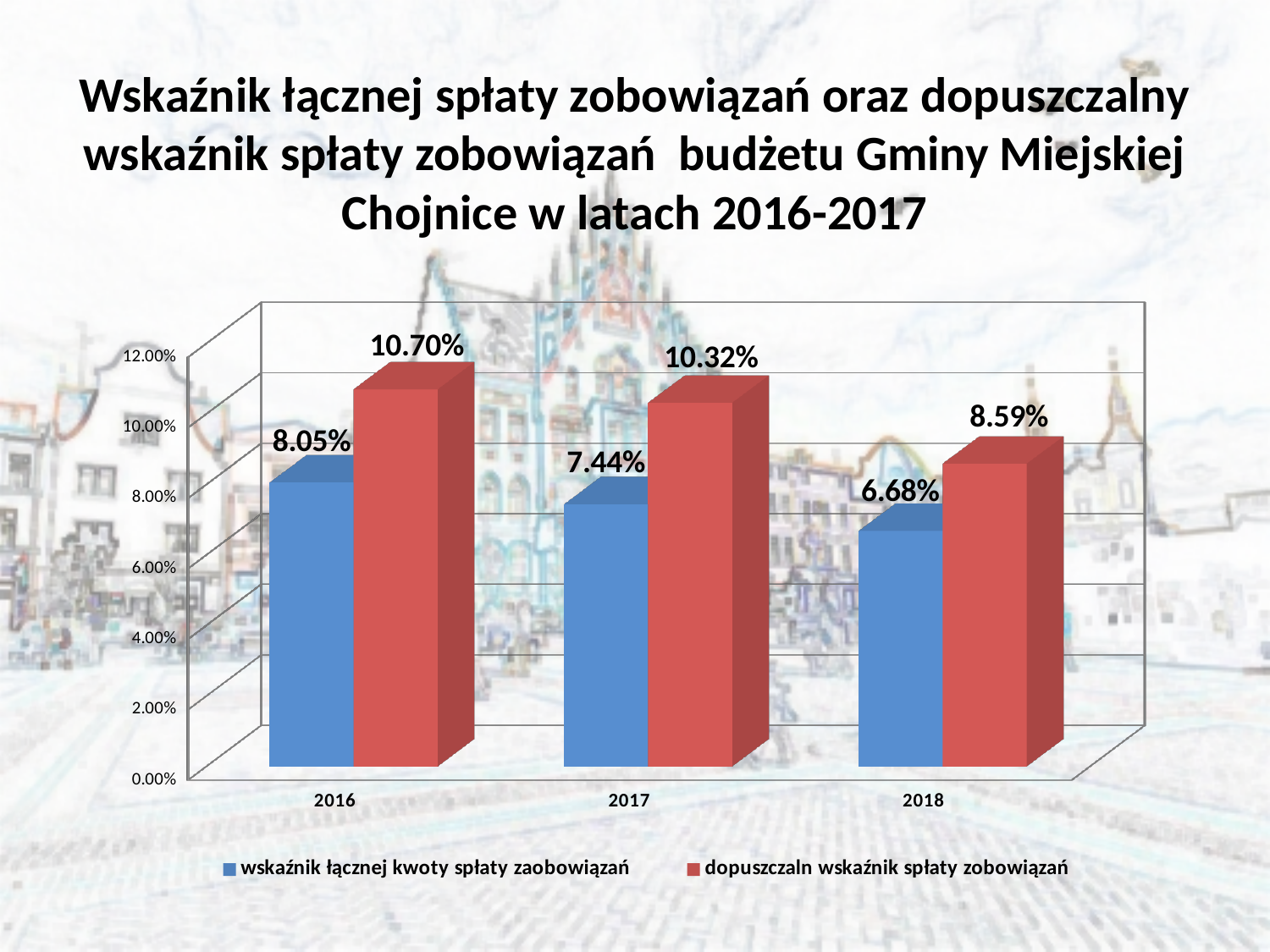
Does 'wskaźnik łącznej kwoty spłaty zaobowiązań' rise or fall from 2016 to 2018? Fall Which is larger in 2016: 'wskaźnik łącznej kwoty spłaty zaobowiązań' or 'dopuszczaln wskaźnik spłaty zobowiązań'? dopuszczaln wskaźnik spłaty zobowiązań What is the value of 'dopuszczaln wskaźnik spłaty zobowiązań' for 2017? 10.32% What kind of chart is shown on the slide? Bar chart What is the value of 'dopuszczaln wskaźnik spłaty zobowiązań' for 2018? 8.59% How many series does the legend list? 2 In which year is 'wskaźnik łącznej kwoty spłaty zaobowiązań' lowest? 2018 What is the difference between 'dopuszczaln wskaźnik spłaty zobowiązań' and 'wskaźnik łącznej kwoty spłaty zaobowiązań' in 2017? 2.88% How many years are shown on the x axis? 3 What is the value of 'wskaźnik łącznej kwoty spłaty zaobowiązań' for 2016? 8.05% In which year is 'dopuszczaln wskaźnik spłaty zobowiązań' highest? 2016 What is the value of 'wskaźnik łącznej kwoty spłaty zaobowiązań' for 2018? 6.68%